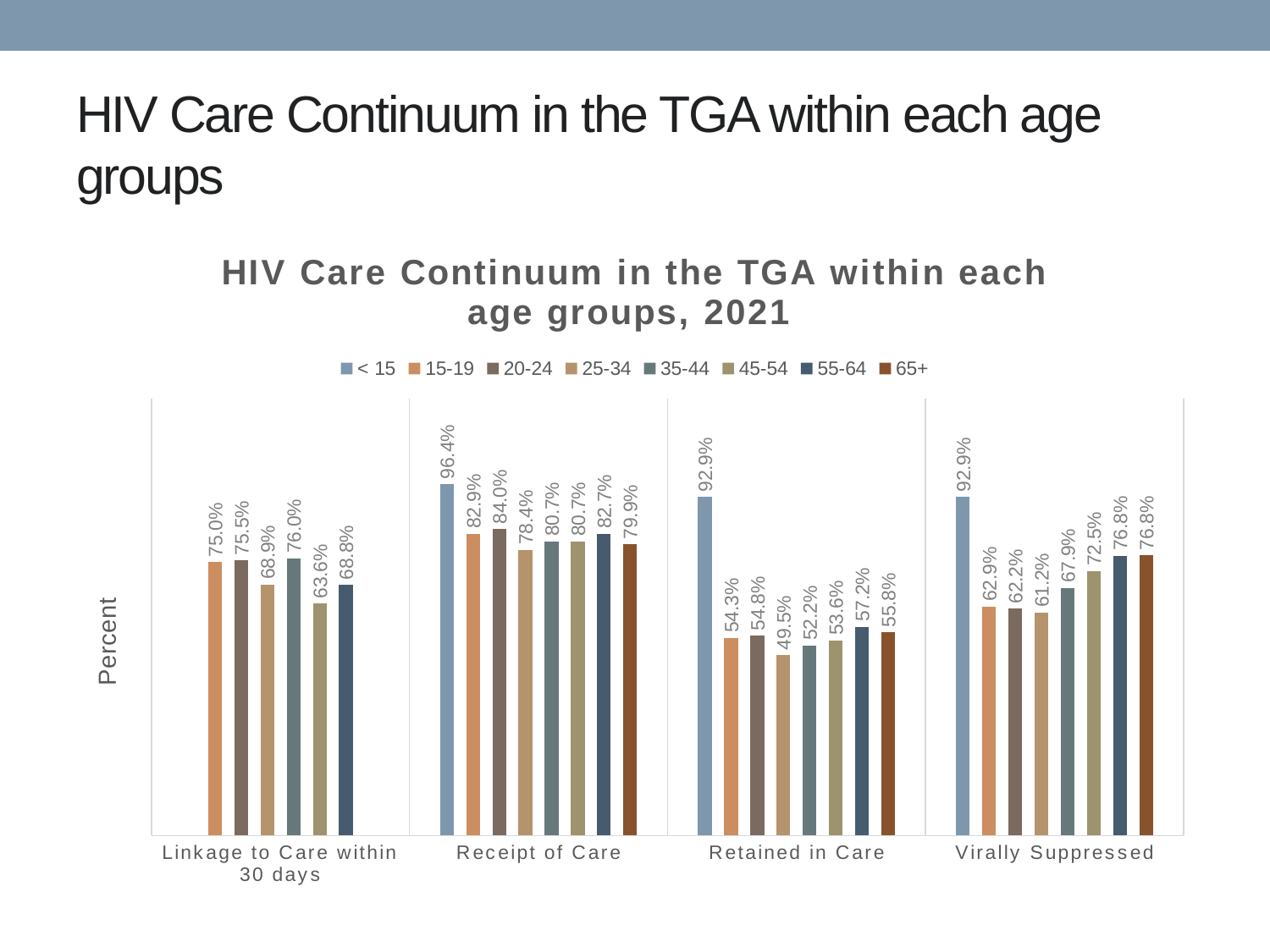
What kind of chart is shown on the slide? Bar chart What is the value for the 55-64 age group in the Virally Suppressed category? 76.8% What is the difference between the < 15 and 15-19 values in the Retained in Care category? 38.6% What is the label on the vertical axis of the chart? Percent Which age group has the highest value in the Virally Suppressed category? < 15 In the Virally Suppressed category, which is larger: the value for 45-54 or the value for 35-44? 45-54 How many care continuum categories are shown on the x axis? 4 What is the value for the 25-34 age group in the Retained in Care category? 49.5% What is the value for the 45-54 age group in the Linkage to Care within 30 days category? 63.6% What is the value for the < 15 age group in the Receipt of Care category? 96.4% How many age groups does the legend list? 8 Which age group has the lowest value in the Retained in Care category? 25-34